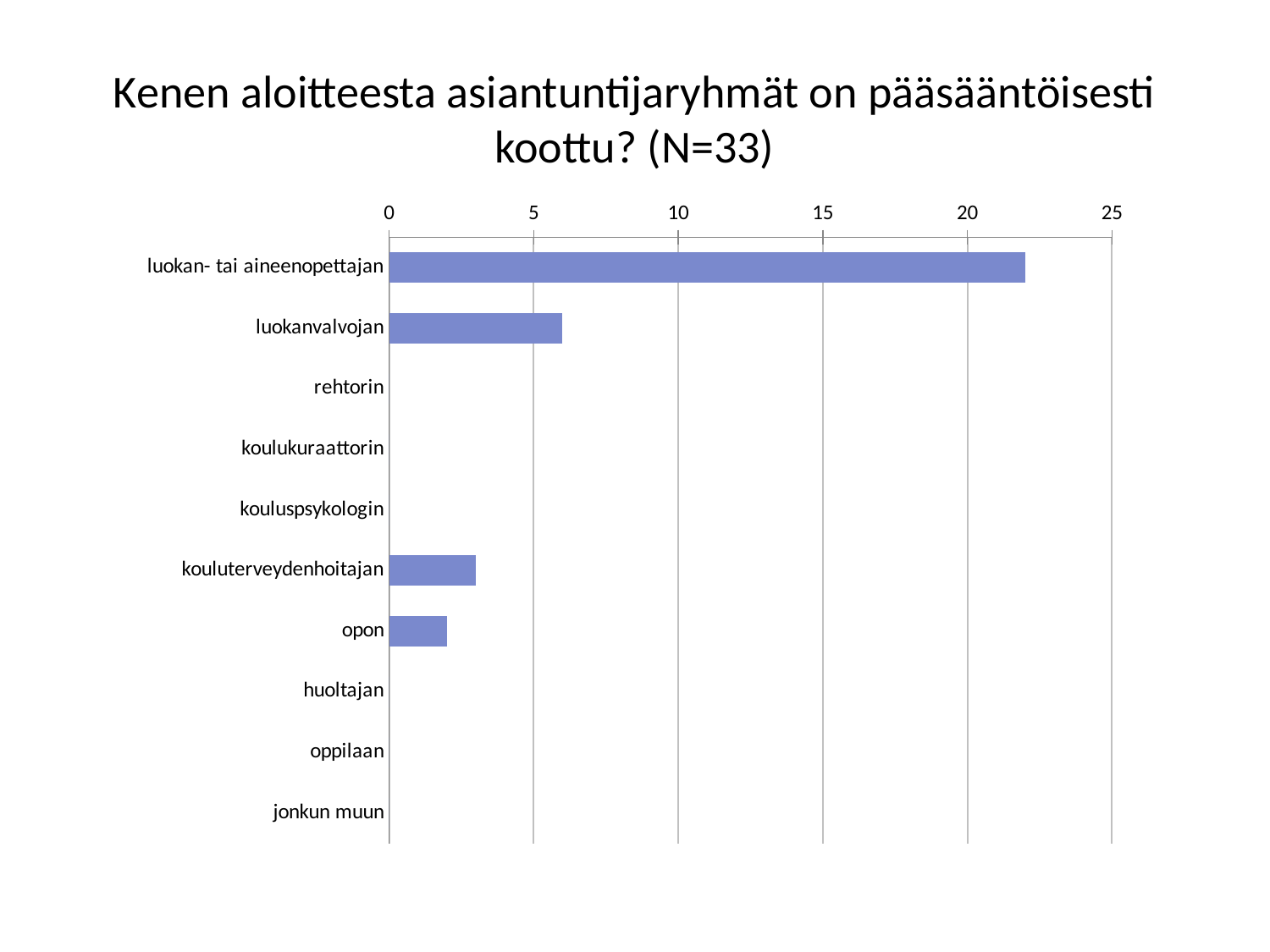
Which category has the highest value in the chart? luokan- tai aineenopettajan What is the maximum value shown on the horizontal axis of the chart? 25 Is the value for luokanvalvojan greater or less than 5? greater Is the value for luokan- tai aineenopettajan greater or less than 20? greater What is the title of the chart? Kenen aloitteesta asiantuntijaryhmät on pääsääntöisesti koottu? (N=33) Which is larger, the value for luokanvalvojan or the value for kouluterveydenhoitajan? luokanvalvojan Is the value for luokanvalvojan greater or less than 10? less Which is larger, the value for kouluterveydenhoitajan or the value for opon? kouluterveydenhoitajan What kind of chart is shown on the slide? bar chart How many categories are listed on the vertical axis of the chart? 10